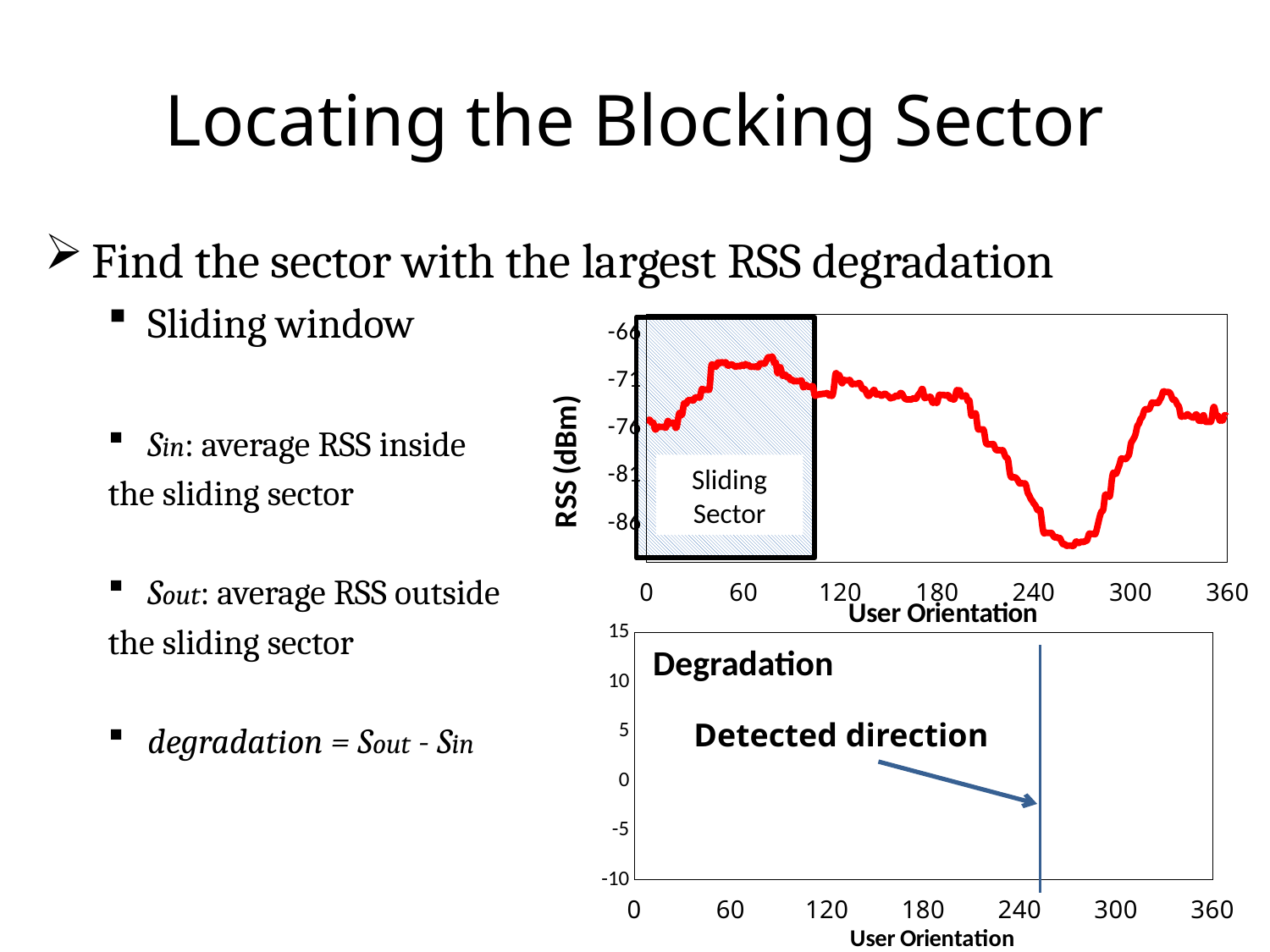
In the top chart (RSS (dBm)), which is larger, the value at a User Orientation of 120 or the value at 240? 120 In the top chart (RSS (dBm)), does the line rise or fall as User Orientation goes from 180 to 240? fall What is the title of the bottom chart? Degradation In the top chart (RSS (dBm)), is the value at a User Orientation of 120 greater or less than -76? greater What kind of chart is the top chart with the y axis labelled RSS (dBm)? line chart In the top chart (RSS (dBm)), between which two x-axis ticks does the line reach its lowest value? 240 and 300 In the top chart (RSS (dBm)), is the value at a User Orientation of 180 greater or less than -76? greater In the top chart (RSS (dBm)), is the value at a User Orientation of 360 greater or less than -81? greater In the top chart (RSS (dBm)), does the line rise or fall as User Orientation goes from 0 to 60? rise How many tick labels are shown on the x axis of the top chart (RSS (dBm))? 7 What label is written inside the shaded box in the top chart? Sliding Sector